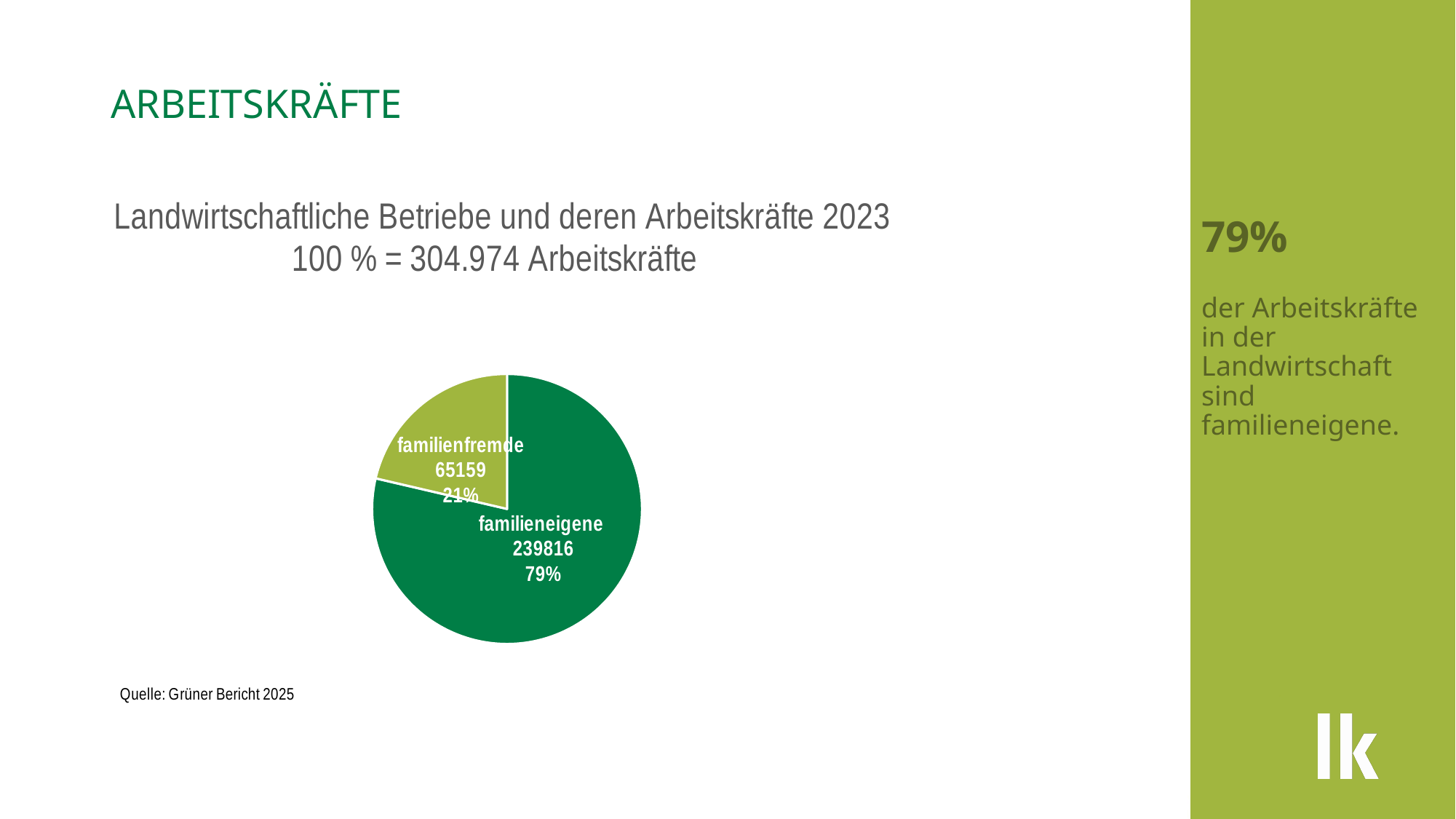
What share of the pie does familieneigene represent? 79% Which slice is the largest? familieneigene Which slice is the smallest? familienfremde What is the value for familienfremde? 65159 What share of the pie does familienfremde represent? 21% What is the value for familieneigene? 239816 What is the difference between the values for familieneigene and familienfremde? 174657 Which is larger, familieneigene or familienfremde? familieneigene How many slices does the pie chart have? 2 What kind of chart is shown on the slide? pie chart What is the total number of Arbeitskräfte stated as 100 % in the chart title? 304.974 What is the source cited below the chart? Grüner Bericht 2025